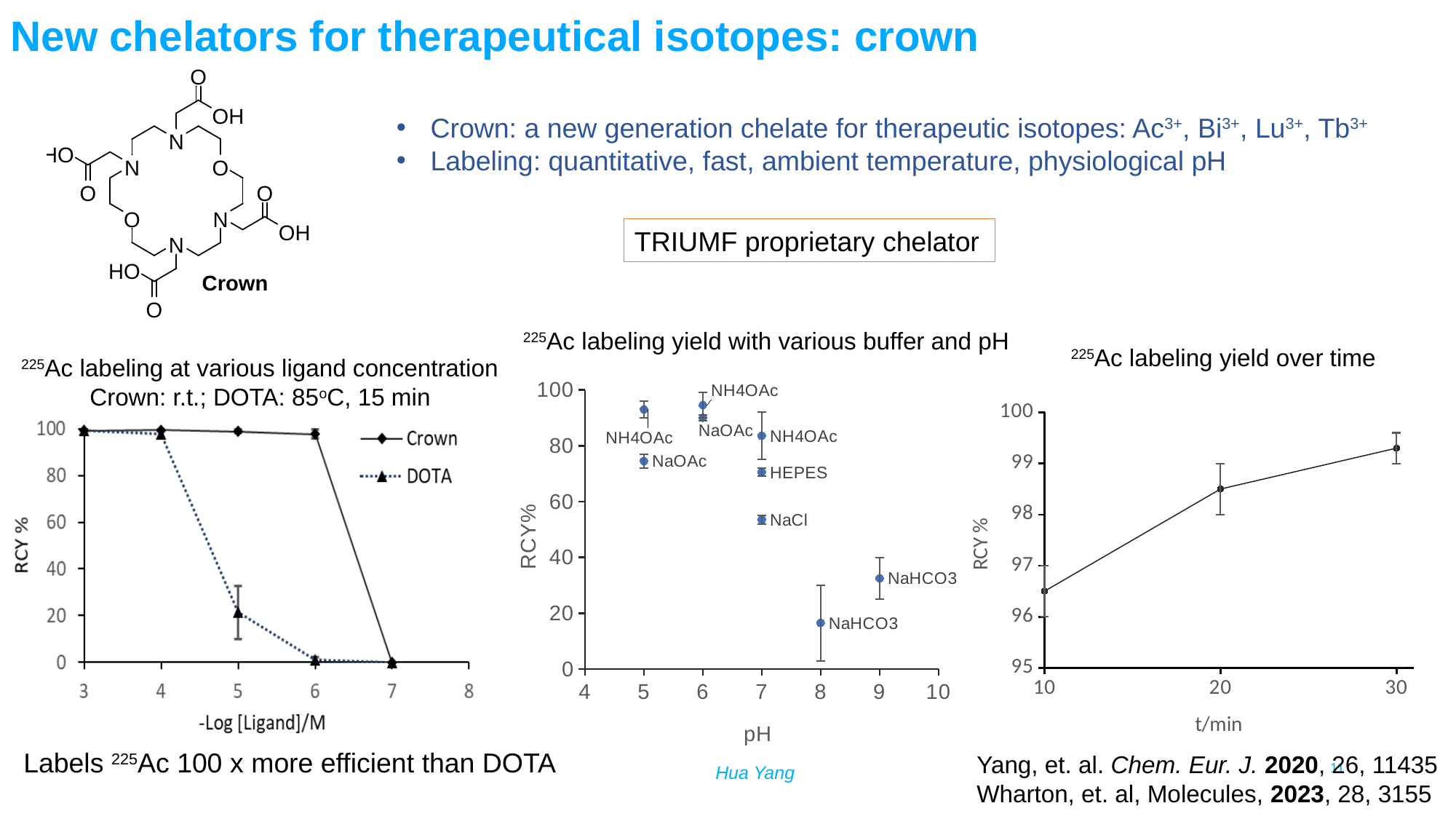
In the chart titled '225Ac labeling at various ligand concentration', which series is plotted with a dotted line? DOTA In the chart titled '225Ac labeling at various ligand concentration', how many series does the legend list? 2 In the chart titled '225Ac labeling yield with various buffer and pH', which has the higher RCY% at pH 7, HEPES or NaCl? HEPES In the chart titled '225Ac labeling at various ligand concentration', at -Log [Ligand]/M = 5, which series has the higher RCY %, Crown or DOTA? Crown In the chart titled '225Ac labeling yield with various buffer and pH', is the RCY% for NaHCO3 at pH 8 greater or less than 20? less In the chart titled '225Ac labeling at various ligand concentration', is the DOTA value at -Log [Ligand]/M = 5 greater or less than 40? less What kind of chart is '225Ac labeling yield with various buffer and pH'? scatter chart In the chart titled '225Ac labeling yield with various buffer and pH', is the RCY% for NaCl greater or less than 60? less In the chart titled '225Ac labeling yield over time', does RCY % rise or fall as t/min increases? rise In the chart titled '225Ac labeling yield over time', how many data points are plotted? 3